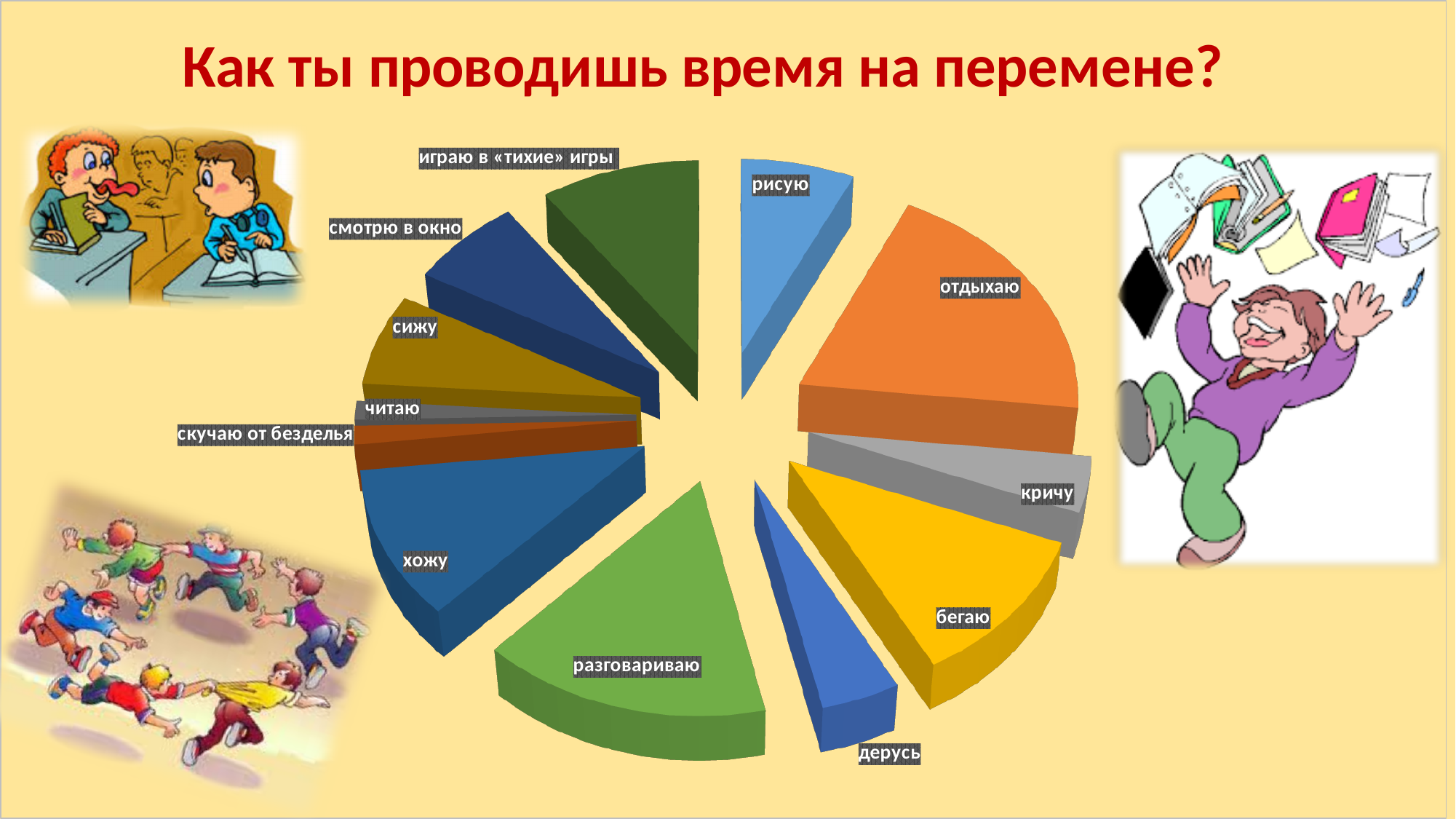
Which slice is larger, бегаю or читаю? бегаю What kind of chart is shown on the slide? pie chart Which slice is larger, хожу or рисую? хожу What colour is the slice labelled бегаю? yellow Which slice is larger, сижу or скучаю от безделья? сижу How many categories (slices) does the pie chart have? 12 What is the title of the slide above the pie chart? Как ты проводишь время на перемене?